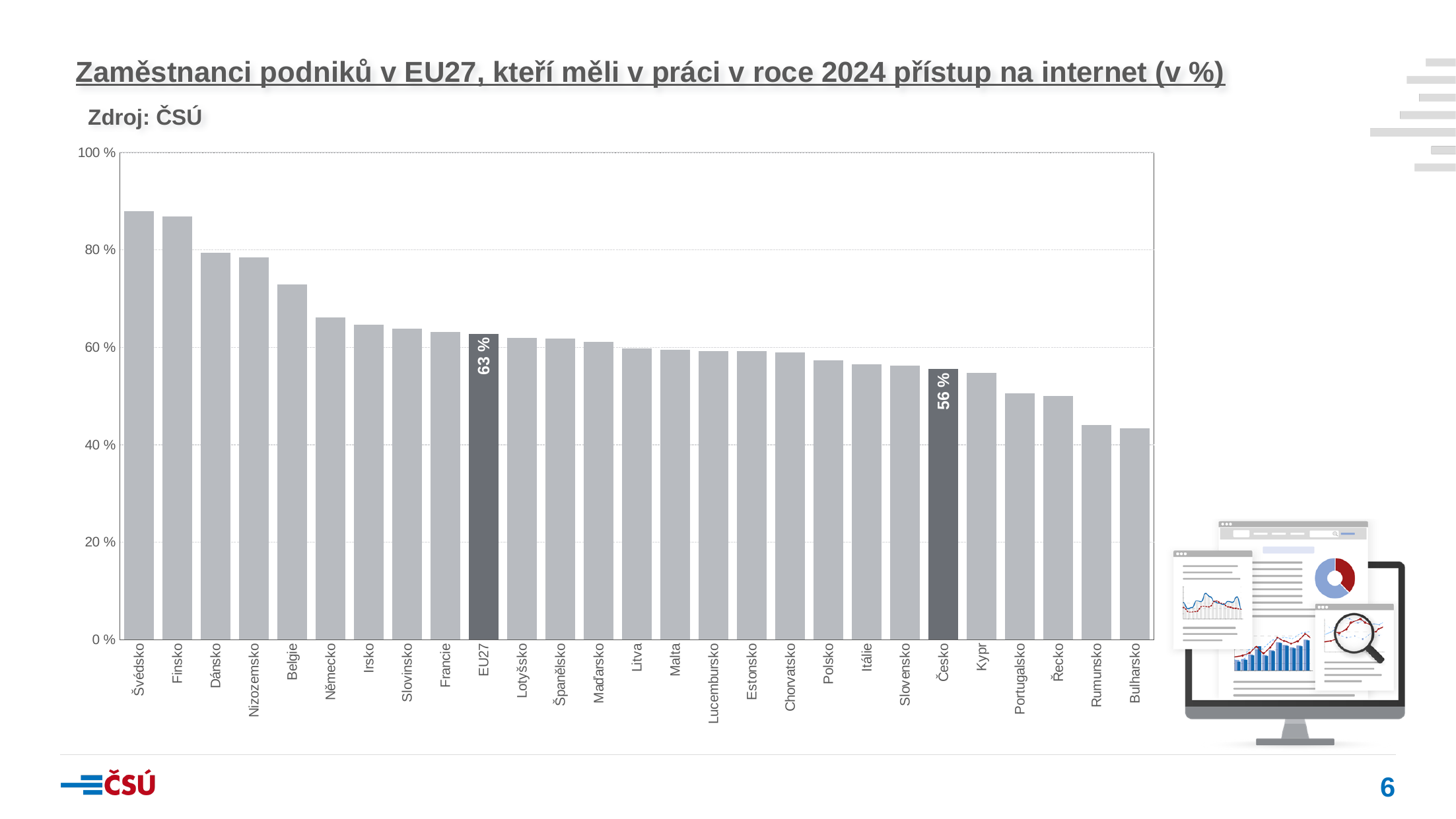
Is the value for Belgie greater or less than 60 %? greater Is the value for Bulharsko greater or less than 40 %? greater What value is shown for Česko? 56 % How many bars are plotted in the chart? 27 Is the value for Švédsko greater or less than 80 %? greater What value is shown for EU27? 63 % What is the difference between the values for EU27 and Česko? 7 % Do the values rise or fall from left to right along the x axis? fall Which is larger, the value for Švédsko or the value for Bulharsko? Švédsko What kind of chart is shown on the slide? bar chart Which is larger, the value for EU27 or the value for Česko? EU27